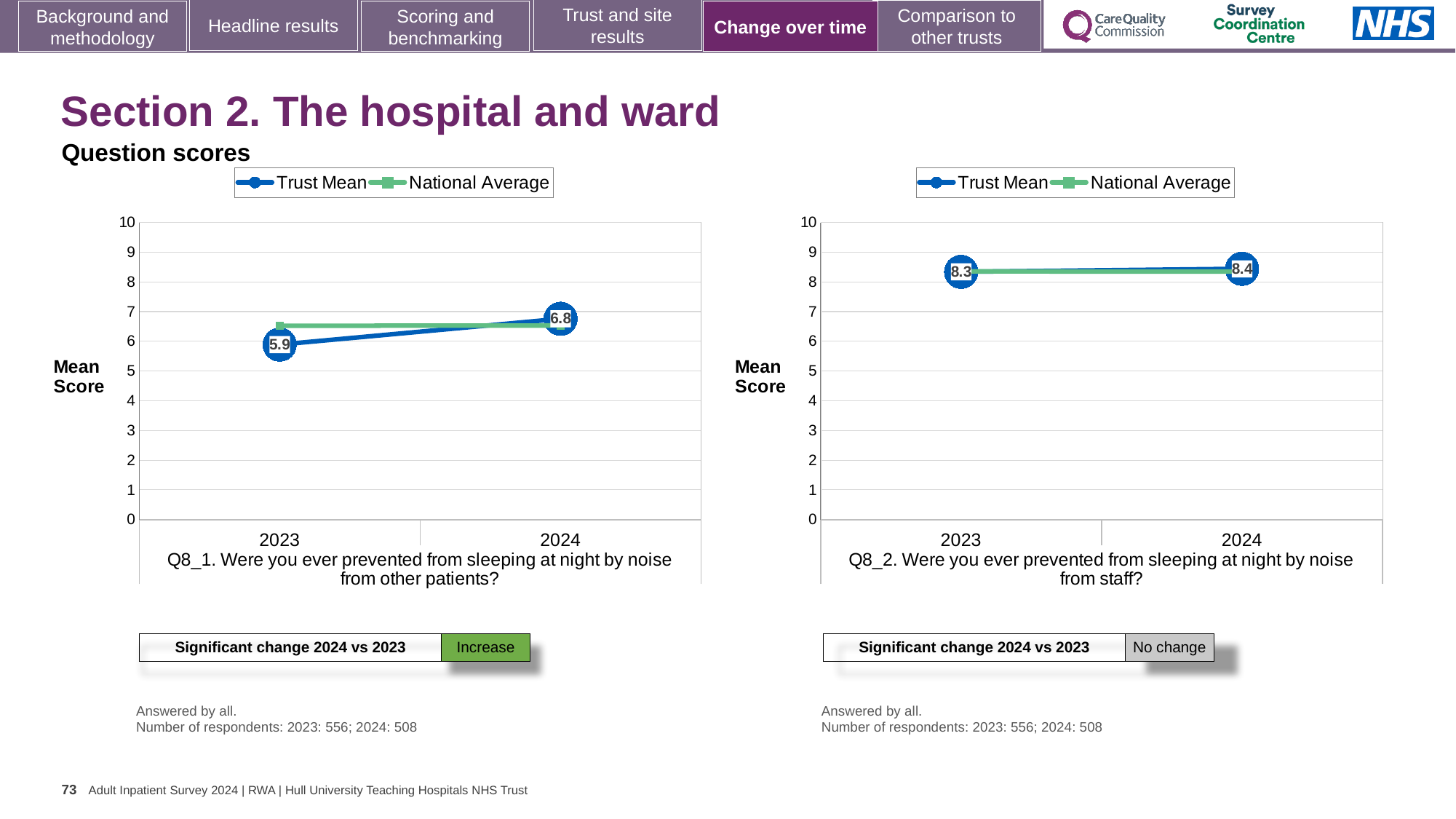
In the Q8_1 chart (left), by how much did the Trust Mean change from 2023 to 2024? 0.9 In the Q8_1 chart (left), what is the Trust Mean for 2023? 5.9 In the Q8_2 chart (right), what is the difference between the Trust Mean for 2024 and 2023? 0.1 In the Q8_1 chart (left), what is the Trust Mean for 2024? 6.8 In the Q8_2 chart (right), what is the Trust Mean for 2023? 8.3 How many series does the legend of the Q8_1 chart (left) list? 2 In the Q8_2 chart (right), what is the Trust Mean for 2024? 8.4 In the Q8_1 chart (left), does the Trust Mean rise or fall from 2023 to 2024? rise In the Q8_1 chart (left), which is higher in 2023, the Trust Mean or the National Average? National Average In the Q8_1 chart (left), is the National Average for 2023 greater or less than 6? greater What type of chart is used for the Q8_2 question scores (right)? line chart How many years are shown on the x axis of the Q8_2 chart (right)? 2